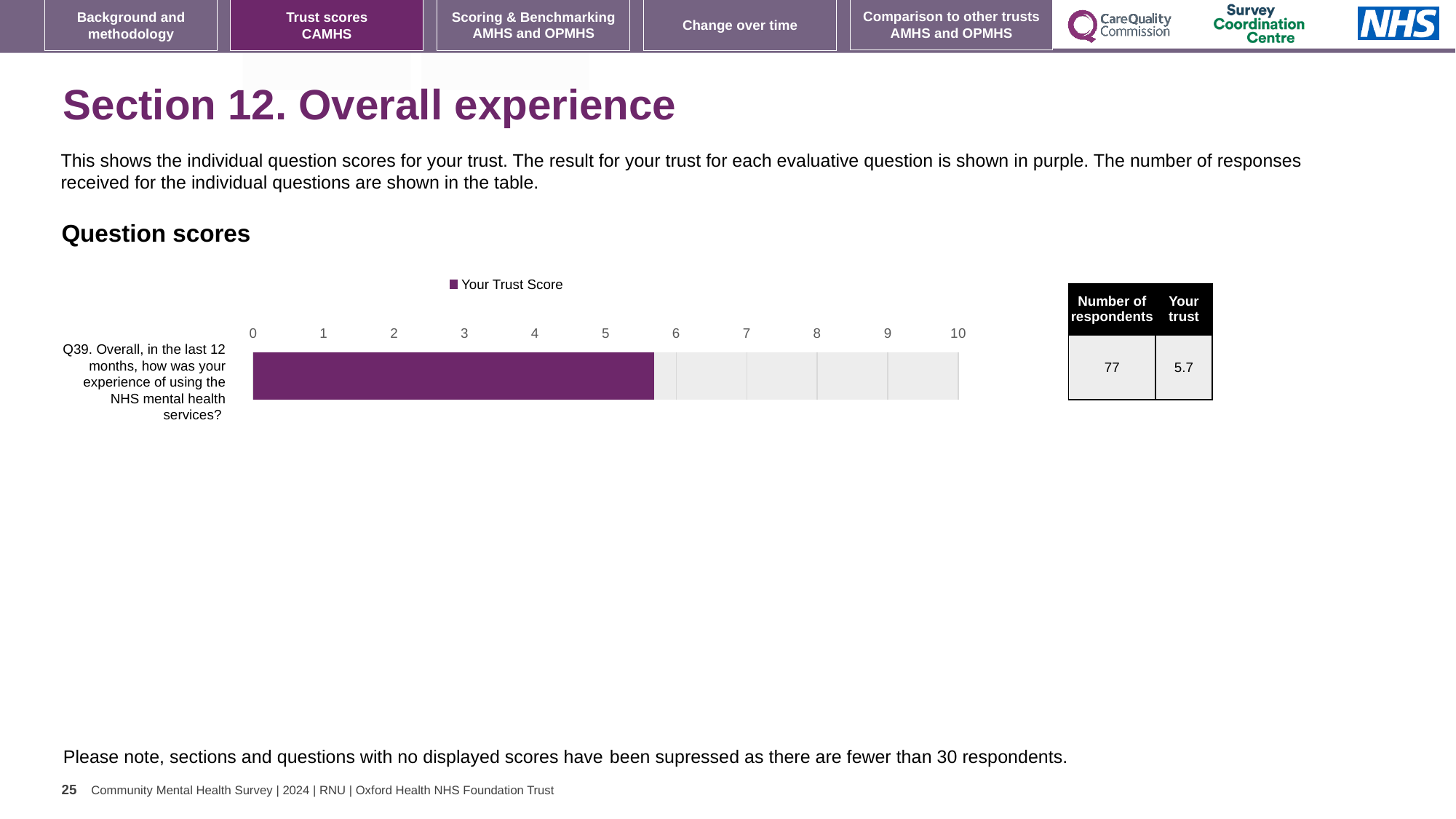
Is the value for Q39 greater or less than 5? greater Is the value for Q39 greater or less than 6? less How many respondents answered Q39 according to the table? 77 How many questions (bars) are plotted in the chart? 1 What is the name of the series shown in the chart legend? Your Trust Score What type of chart is shown under 'Question scores'? bar chart What is the maximum value shown on the chart's x axis? 10 Which question is plotted in the chart? Q39. Overall, in the last 12 months, how was your experience of using the NHS mental health services? What is the trust score for Q39 as shown in the table next to the chart? 5.7 How many series does the chart legend list? 1